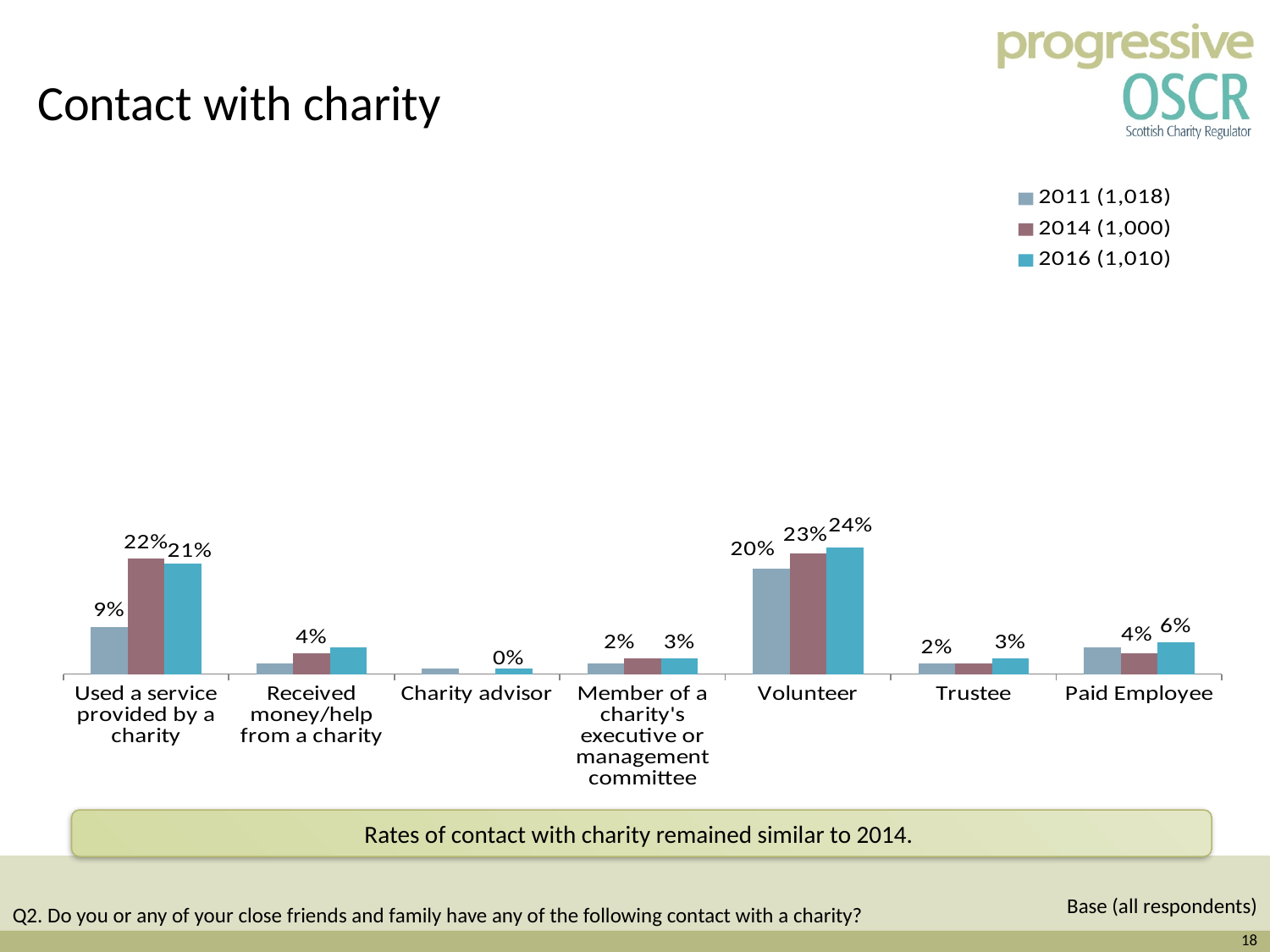
What is the difference between the 2016 and 2011 values for Volunteer? 4 percentage points What is the 2011 value for 'Used a service provided by a charity'? 9% Which is larger in 2016: Volunteer or 'Used a service provided by a charity'? Volunteer Which category has the highest 2016 value? Volunteer Which category has the lowest 2016 value? Charity advisor What type of chart is shown on the slide? Bar chart What is the 2016 value for Paid Employee? 6% How many series does the legend list? 3 What is the difference between the 2014 and 2011 values for 'Used a service provided by a charity'? 13 percentage points How many categories are shown along the x axis? 7 What is the full legend entry for the 2014 series? 2014 (1,000) What is the 2016 value for Volunteer? 24%